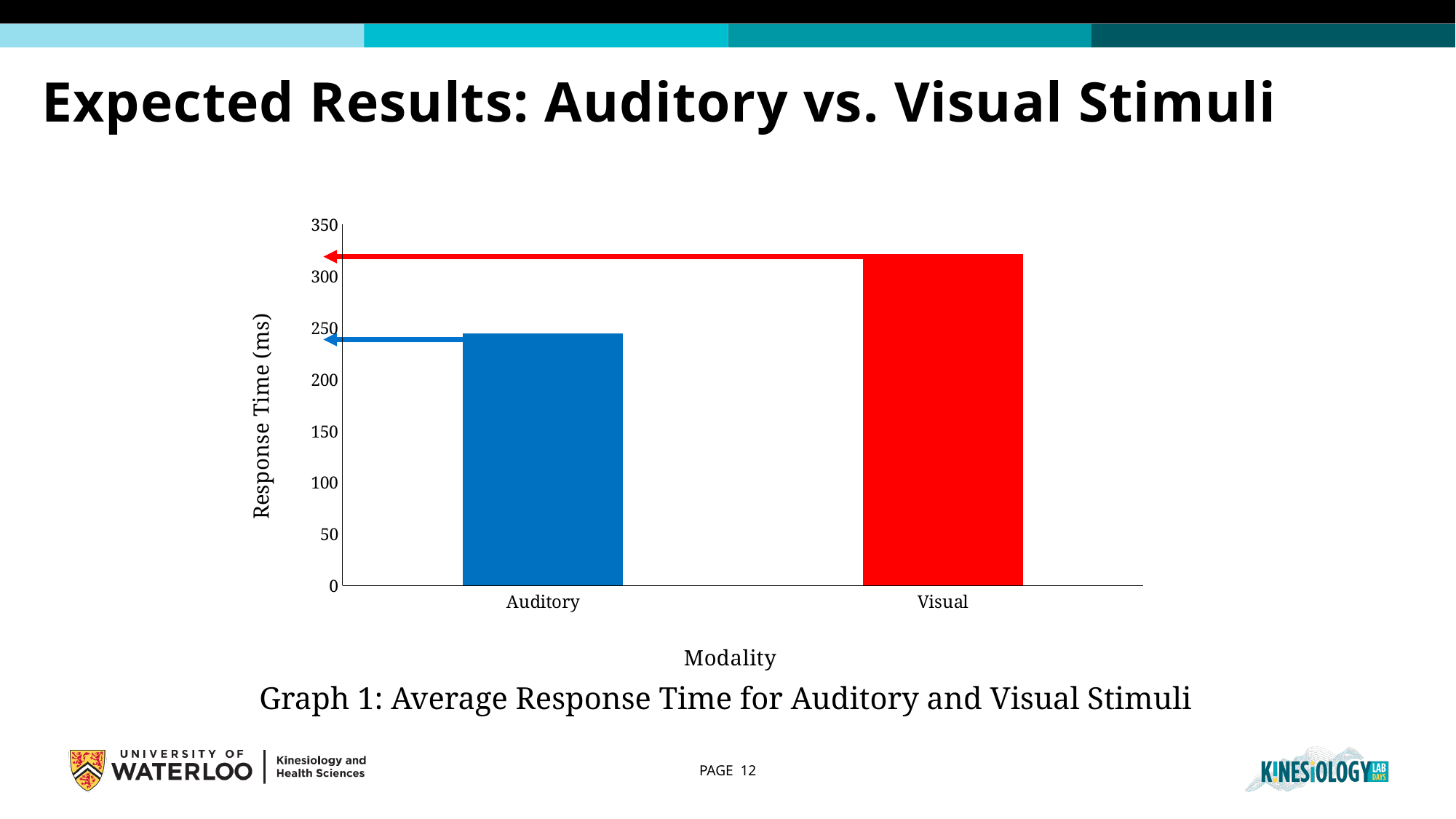
Is the response time for Auditory greater or less than 200? greater Which has a larger response time, Auditory or Visual? Visual What kind of chart is shown on the slide? bar chart Is the response time for Visual greater or less than 300? greater Is the response time for Auditory greater or less than 300? less How many categories are plotted on the x axis of the chart? 2 Which modality has the highest average response time? Visual What is the label of the y axis of the chart? Response Time (ms) What is the caption given below the chart? Graph 1: Average Response Time for Auditory and Visual Stimuli Which modality has the lowest average response time? Auditory